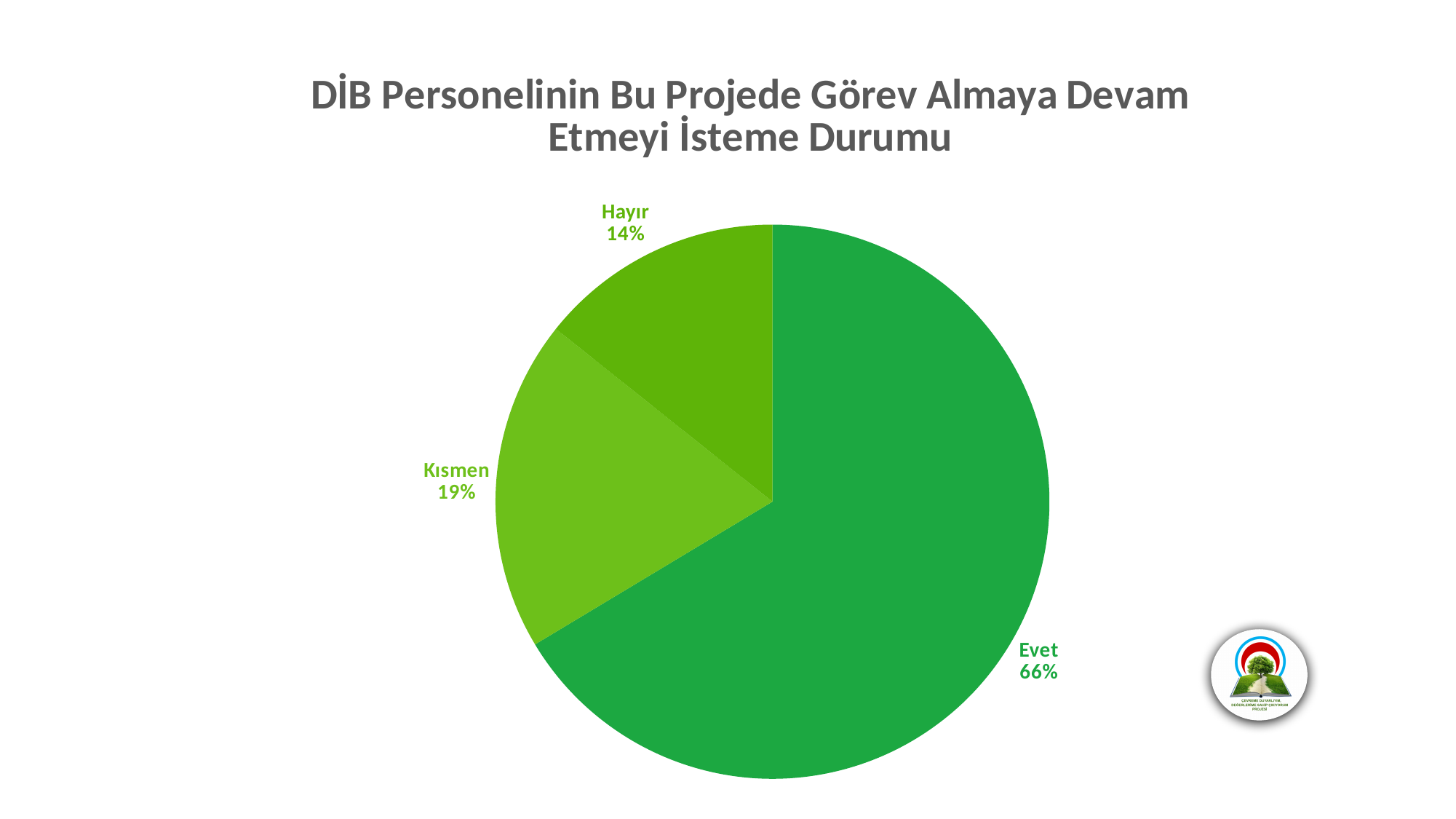
Which is larger, the share for Kısmen or the share for Hayır? Kısmen What is the combined share of Kısmen and Hayır? 33% Which category has the smallest slice of the pie? Hayır What share of the pie does Evet represent? 66% Which category has the largest slice of the pie? Evet What is the title of the chart? DİB Personelinin Bu Projede Görev Almaya Devam Etmeyi İsteme Durumu What is the difference in percentage points between Kısmen and Hayır? 5 How many categories are shown in the pie chart? 3 What share of the pie does Kısmen represent? 19% What share of the pie does Hayır represent? 14% What kind of chart is shown on the slide? Pie chart What is the difference in percentage points between Evet and Kısmen? 47